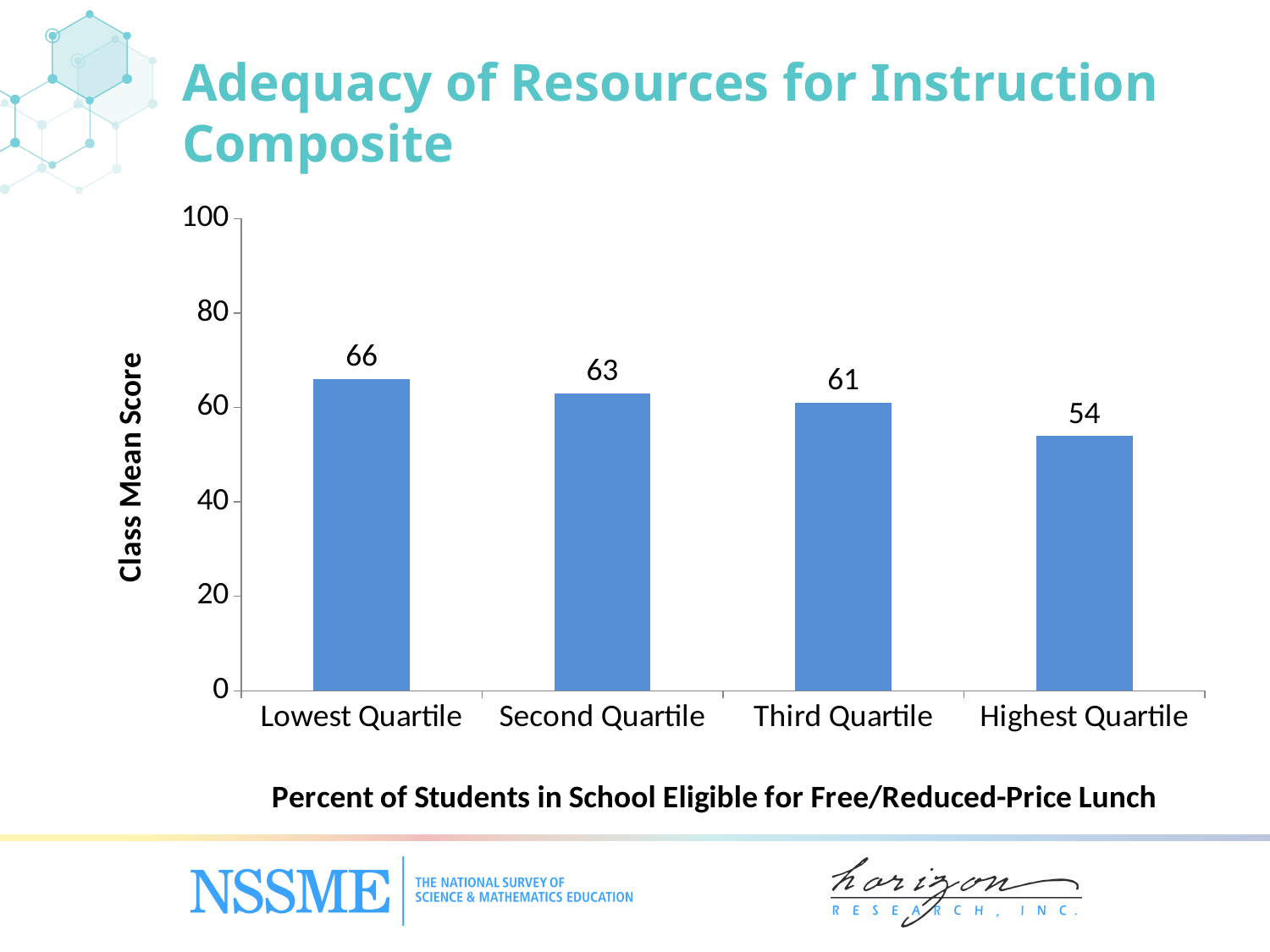
What is the difference between the class mean scores of the Lowest Quartile and the Highest Quartile? 12 How many quartile categories are shown on the x axis? 4 Is the class mean score for the Highest Quartile greater or less than 60? less Which has a larger class mean score, the Second Quartile or the Highest Quartile? Second Quartile What is the class mean score for the Third Quartile? 61 What is the class mean score for the Lowest Quartile? 66 Which quartile has the lowest class mean score? Highest Quartile What kind of chart is shown on the slide? bar chart Which quartile has the highest class mean score? Lowest Quartile What is the difference between the class mean scores of the Second Quartile and the Third Quartile? 2 What is the class mean score for the Highest Quartile? 54 Do the class mean scores rise or fall from the Lowest Quartile to the Highest Quartile? fall